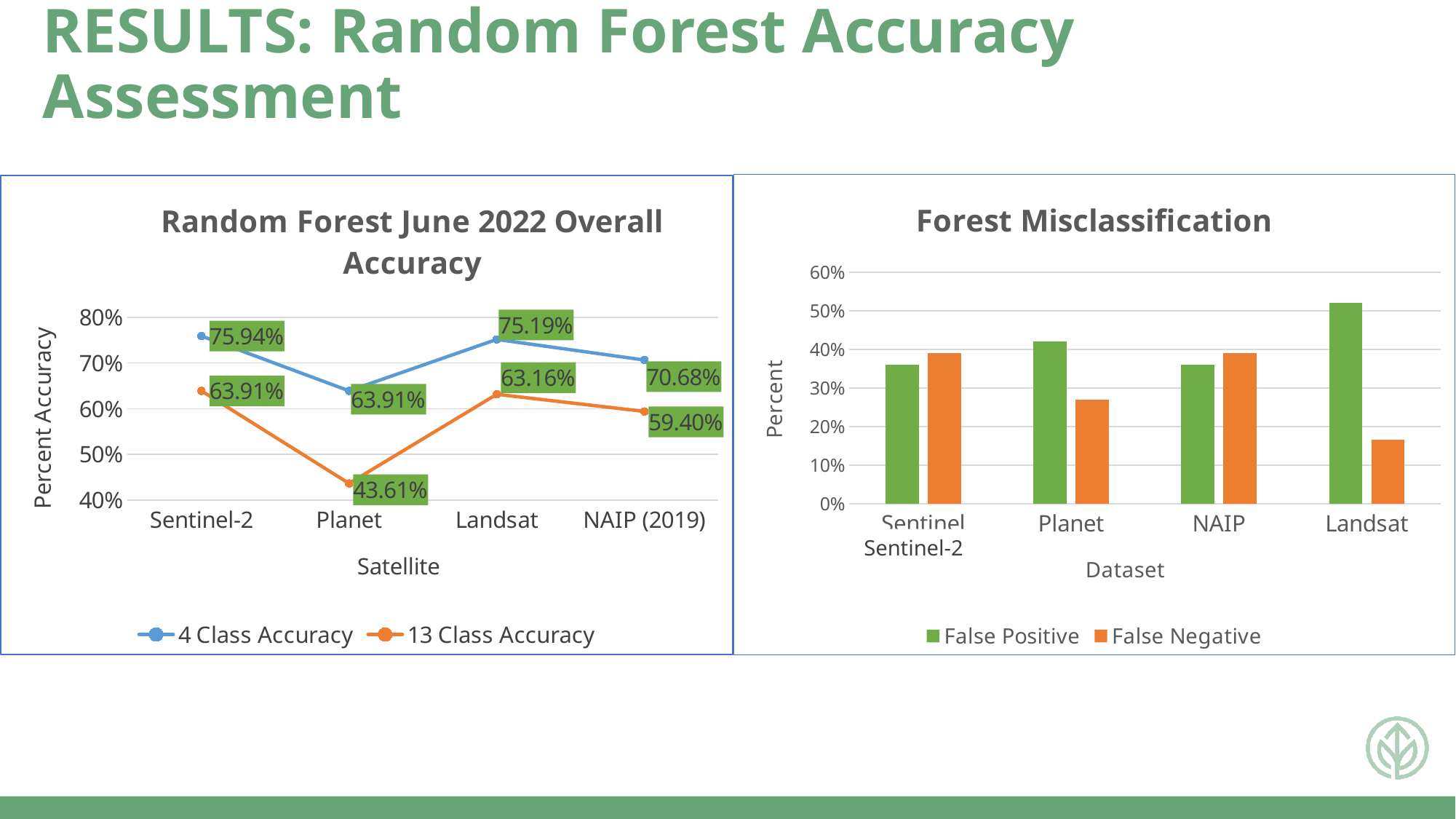
In the Forest Misclassification chart, is the False Negative value for Landsat greater or less than 20%? less What kind of chart is the Random Forest June 2022 Overall Accuracy chart? Line chart In the Random Forest June 2022 Overall Accuracy chart, what is the difference between the 4 Class Accuracy and the 13 Class Accuracy for Planet? 20.30 percentage points In the Random Forest June 2022 Overall Accuracy chart, what is the 13 Class Accuracy for Planet? 43.61% In the Forest Misclassification chart, which is larger for Planet, False Positive or False Negative? False Positive In the Random Forest June 2022 Overall Accuracy chart, which satellite has the lowest 13 Class Accuracy? Planet In the Random Forest June 2022 Overall Accuracy chart, what is the 13 Class Accuracy for NAIP (2019)? 59.40% In the Forest Misclassification chart, is the False Positive value for Landsat greater or less than 50%? greater In the Random Forest June 2022 Overall Accuracy chart, how many series does the legend list? 2 How many datasets are shown on the x axis of the Forest Misclassification chart? 4 In the Random Forest June 2022 Overall Accuracy chart, what is the 4 Class Accuracy for Sentinel-2? 75.94% In the Forest Misclassification chart, which dataset has the highest False Positive value? Landsat